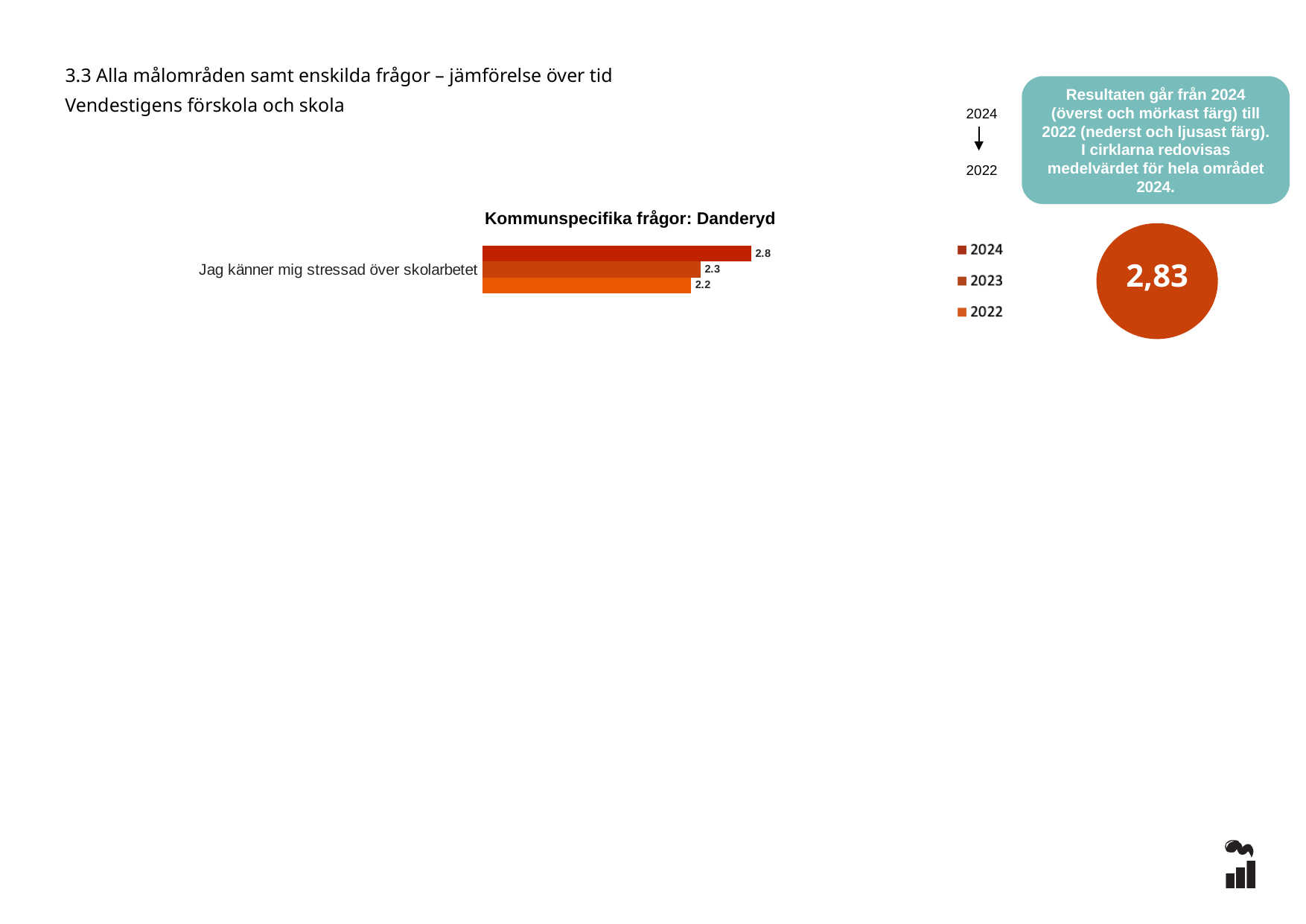
What is the value for 2024 for "Jag känner mig stressad över skolarbetet"? 2.8 What value is shown in the circle next to the chart? 2,83 Which year has the highest value for "Jag känner mig stressad över skolarbetet"? 2024 What is the value for 2022 for "Jag känner mig stressad över skolarbetet"? 2.2 What kind of chart is shown? Bar chart What is the difference between the 2024 and 2022 values for "Jag känner mig stressad över skolarbetet"? 0.6 What is the title of the chart? Kommunspecifika frågor: Danderyd How many series does the legend list? 3 What is the difference between the 2024 and 2023 values for "Jag känner mig stressad över skolarbetet"? 0.5 Is the 2024 value or the 2023 value larger for "Jag känner mig stressad över skolarbetet"? 2024 Which year has the lowest value for "Jag känner mig stressad över skolarbetet"? 2022 What is the value for 2023 for "Jag känner mig stressad över skolarbetet"? 2.3